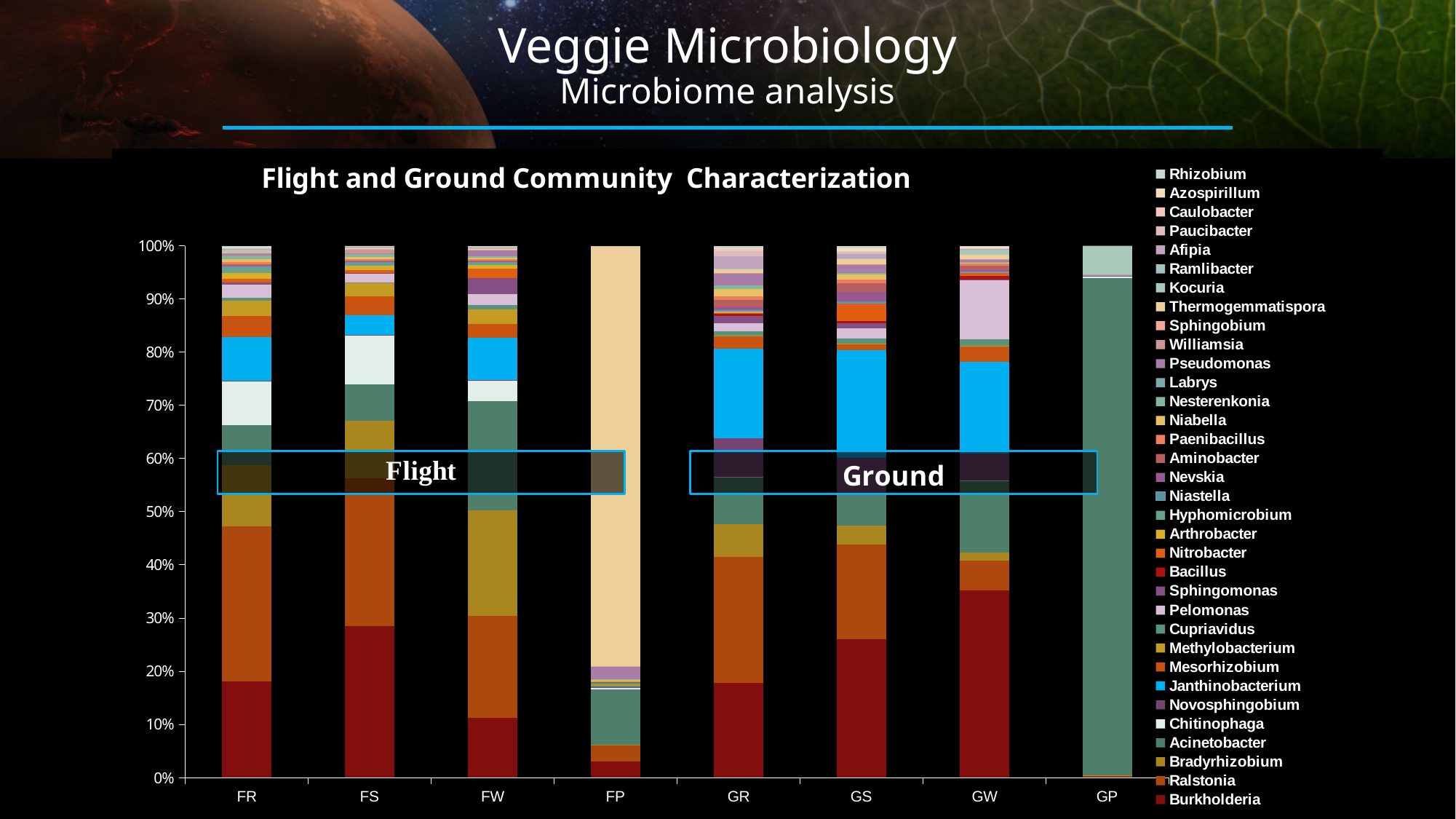
Which category has the smallest Burkholderia share? GP What is the title of the chart? Flight and Ground Community Characterization How many series does the chart's legend list? 34 Which bar has the larger Burkholderia share, FR or GW? GW Which categories are grouped under the label "Flight"? FR, FS, FW, FP How many categories are shown along the x axis of the chart? 8 What is the total height of each stacked bar on the percentage axis? 100% Is the Acinetobacter share in the GP bar greater or less than 90%? greater What kind of chart is shown on the slide? Stacked bar chart Is the Thermogemmatispora share in the FP bar greater or less than 70%? greater Is the Burkholderia share in the FP bar greater or less than 10%? less